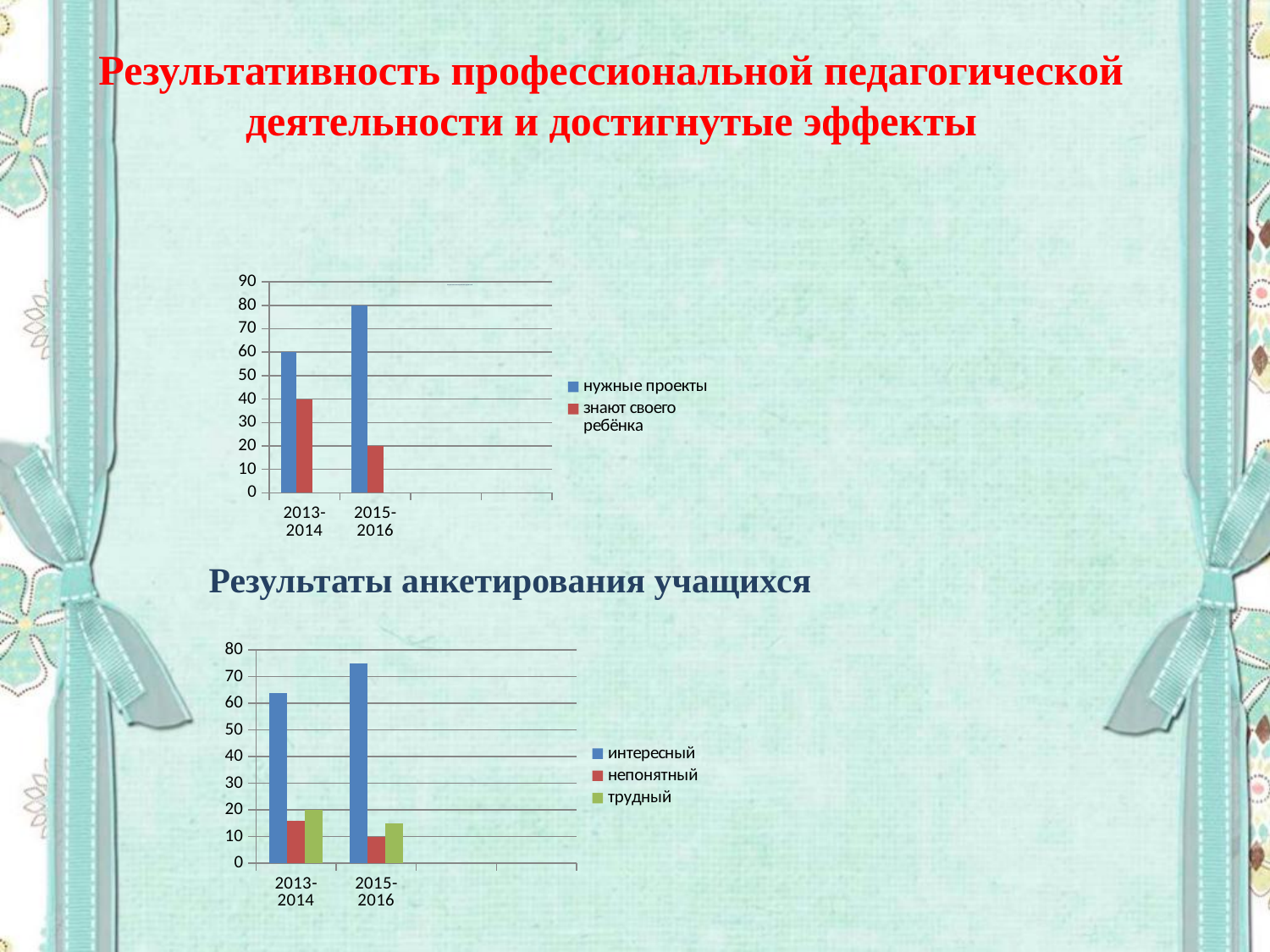
In the bottom chart (Результаты анкетирования учащихся), which series has the highest value in 2013-2014? интересный In the top chart, what is the value for нужные проекты in 2013-2014? 60 How many series does the legend of the top chart list? 2 In the top chart, what is the value for знают своего ребёнка in 2013-2014? 40 In the bottom chart (Результаты анкетирования учащихся), is the value for интересный in 2015-2016 greater or less than 70? greater In the bottom chart (Результаты анкетирования учащихся), what is the value for трудный in 2013-2014? 20 In the top chart, what is the value for знают своего ребёнка in 2015-2016? 20 In the top chart, what is the difference between нужные проекты in 2015-2016 and in 2013-2014? 20 In the bottom chart (Результаты анкетирования учащихся), what is the value for непонятный in 2015-2016? 10 What kind of chart is the bottom chart (Результаты анкетирования учащихся)? bar chart In the top chart, what is the value for нужные проекты in 2015-2016? 80 In the top chart, does the value for знают своего ребёнка rise or fall from 2013-2014 to 2015-2016? fall